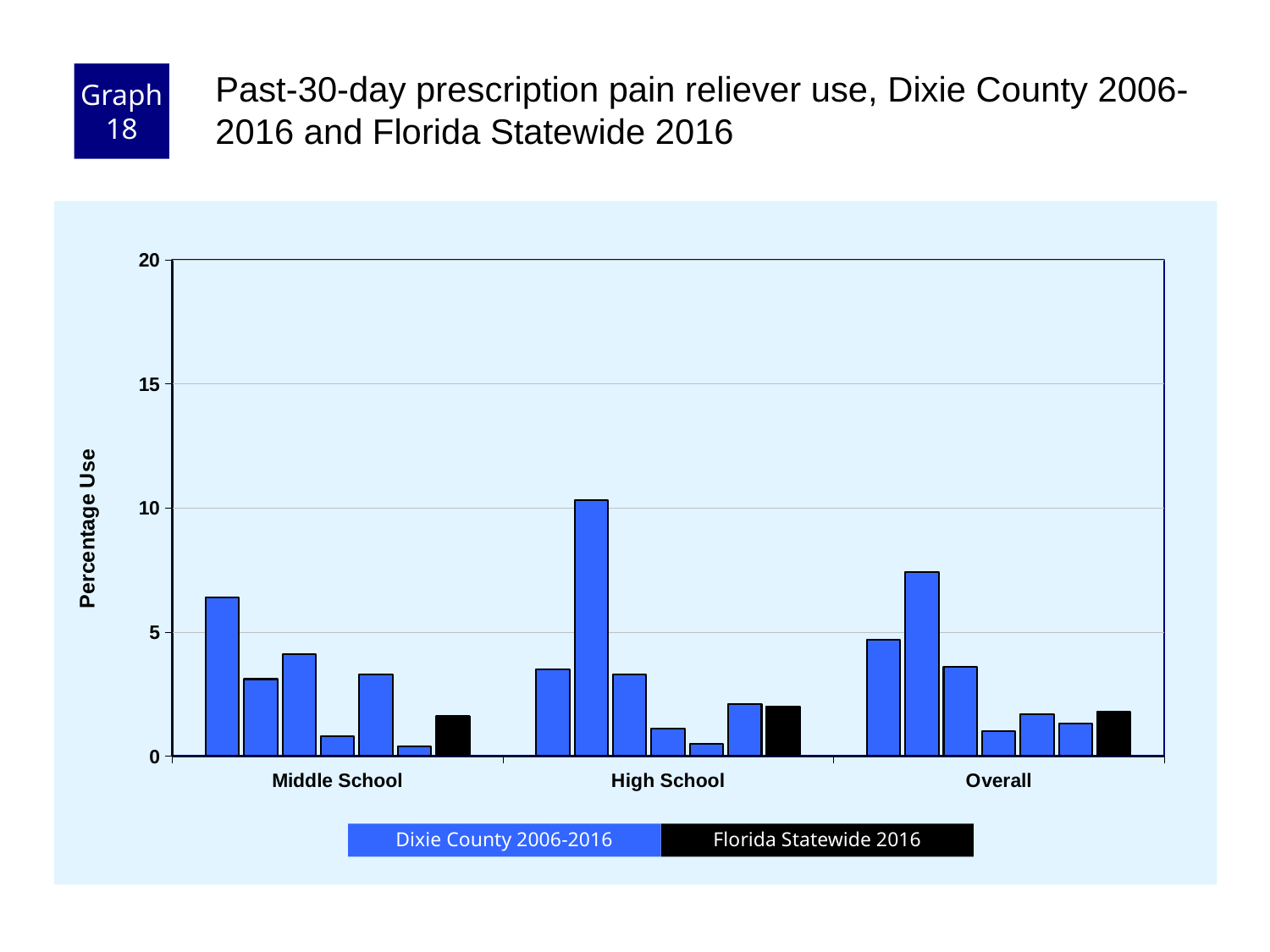
In the Overall group, which is larger: the tallest Dixie County 2006-2016 bar or the Florida Statewide 2016 bar? the tallest Dixie County 2006-2016 bar What is the label of the y axis? Percentage Use Is the tallest Dixie County 2006-2016 bar in the High School group greater or less than 5? greater How many categories are shown on the x axis of the chart? 3 Is the Florida Statewide 2016 value for Middle School greater or less than 5? less How many series does the chart legend list? 2 Which x-axis category contains the tallest bar in the chart? High School Is the Florida Statewide 2016 value for High School greater or less than 5? less Which colour represents Florida Statewide 2016 in the chart? black What kind of chart is shown on the slide? bar chart What is the highest value shown on the y axis? 20